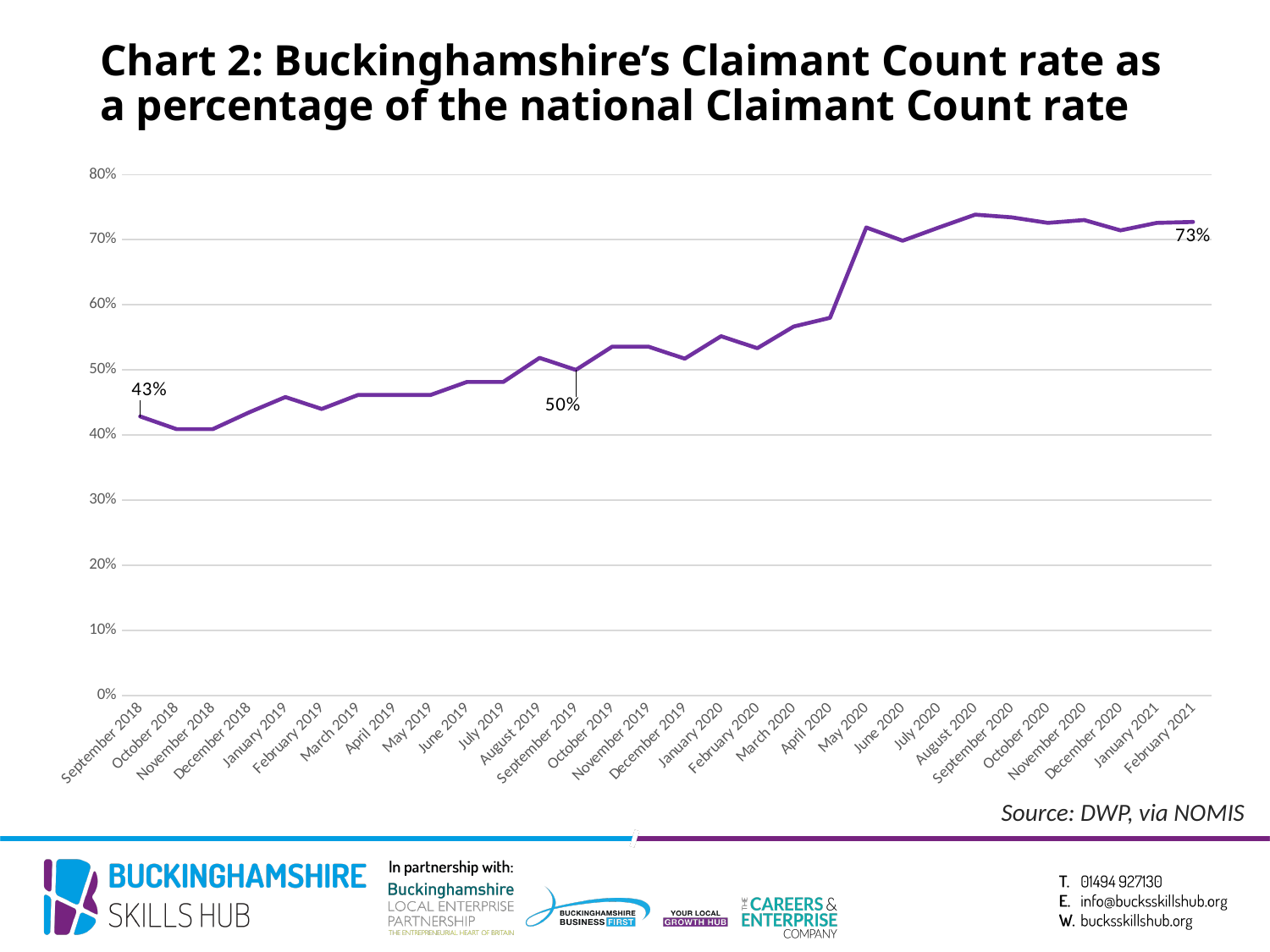
Which is larger, the value for February 2021 or the value for September 2018? February 2021 What kind of chart is shown on the slide? Line chart Overall, do the values rise or fall from September 2018 to February 2021? Rise What is the value for September 2019? 50% Is the value for December 2019 greater or less than 60%? less By how many percentage points does the value for February 2021 exceed the value for September 2018? 30 percentage points What is the value for September 2018? 43% What is the source cited for the chart? DWP, via NOMIS What is the difference between the values for September 2019 and September 2018? 7 percentage points Is the value for October 2018 greater or less than 50%? less What is the value for February 2021? 73% Is the value for May 2020 greater or less than 70%? greater